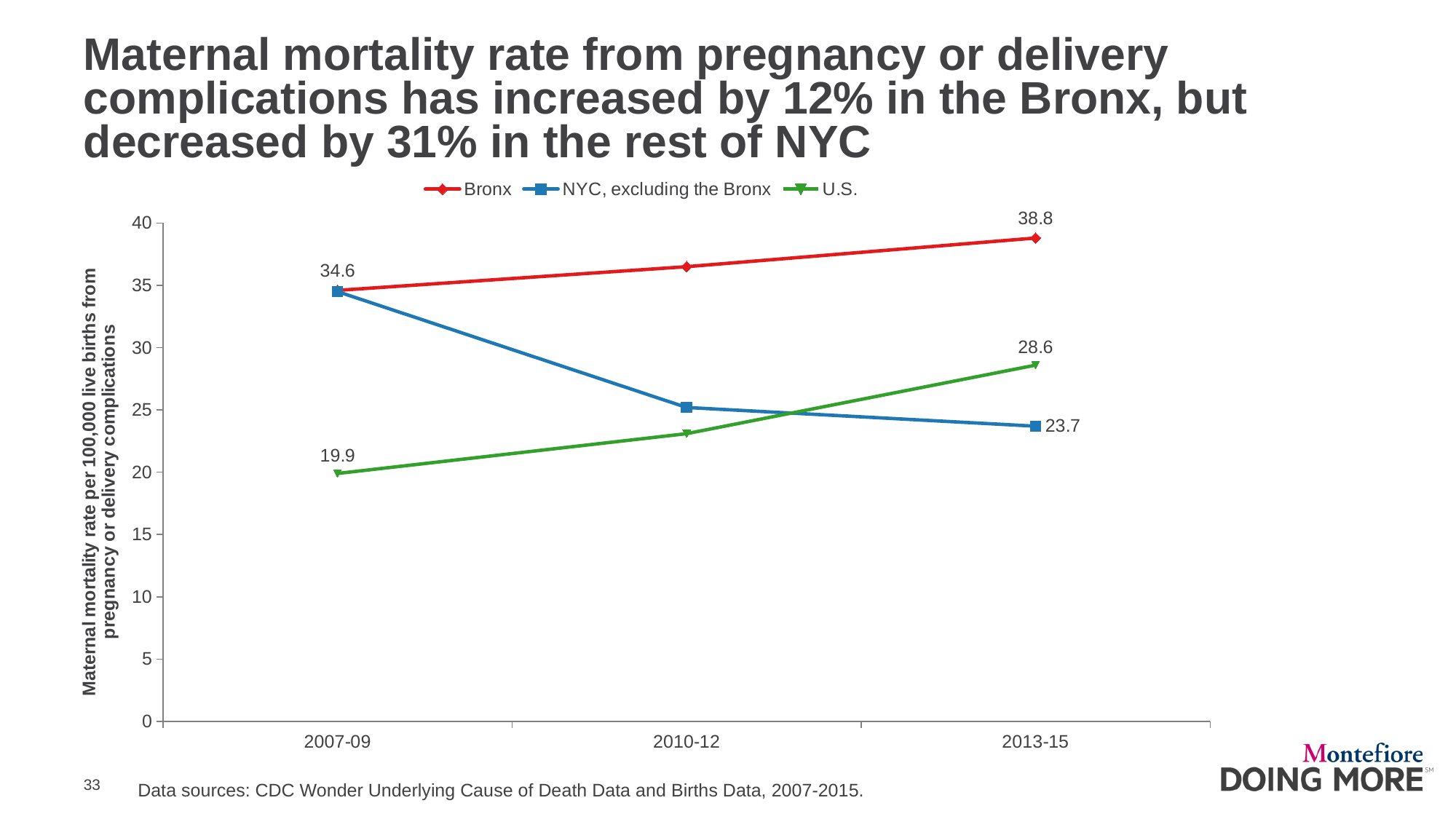
How many series does the legend list? 3 How many time periods are shown on the x axis? 3 Which series has the highest value in 2013-15? Bronx What is the difference between the Bronx rate and the NYC, excluding the Bronx rate in 2013-15? 15.1 Is the Bronx value for 2010-12 greater or less than 35? greater By how much did the U.S. maternal mortality rate change from 2007-09 (19.9) to 2013-15 (28.6)? 8.7 Does the U.S. maternal mortality rate rise or fall from 2007-09 to 2013-15? rise What is the maternal mortality rate for the Bronx in 2013-15? 38.8 What is the maternal mortality rate for the U.S. in 2007-09? 19.9 Which series has the lowest value in 2007-09? U.S. What type of chart is shown on the slide? line chart What is the maternal mortality rate for NYC, excluding the Bronx in 2013-15? 23.7